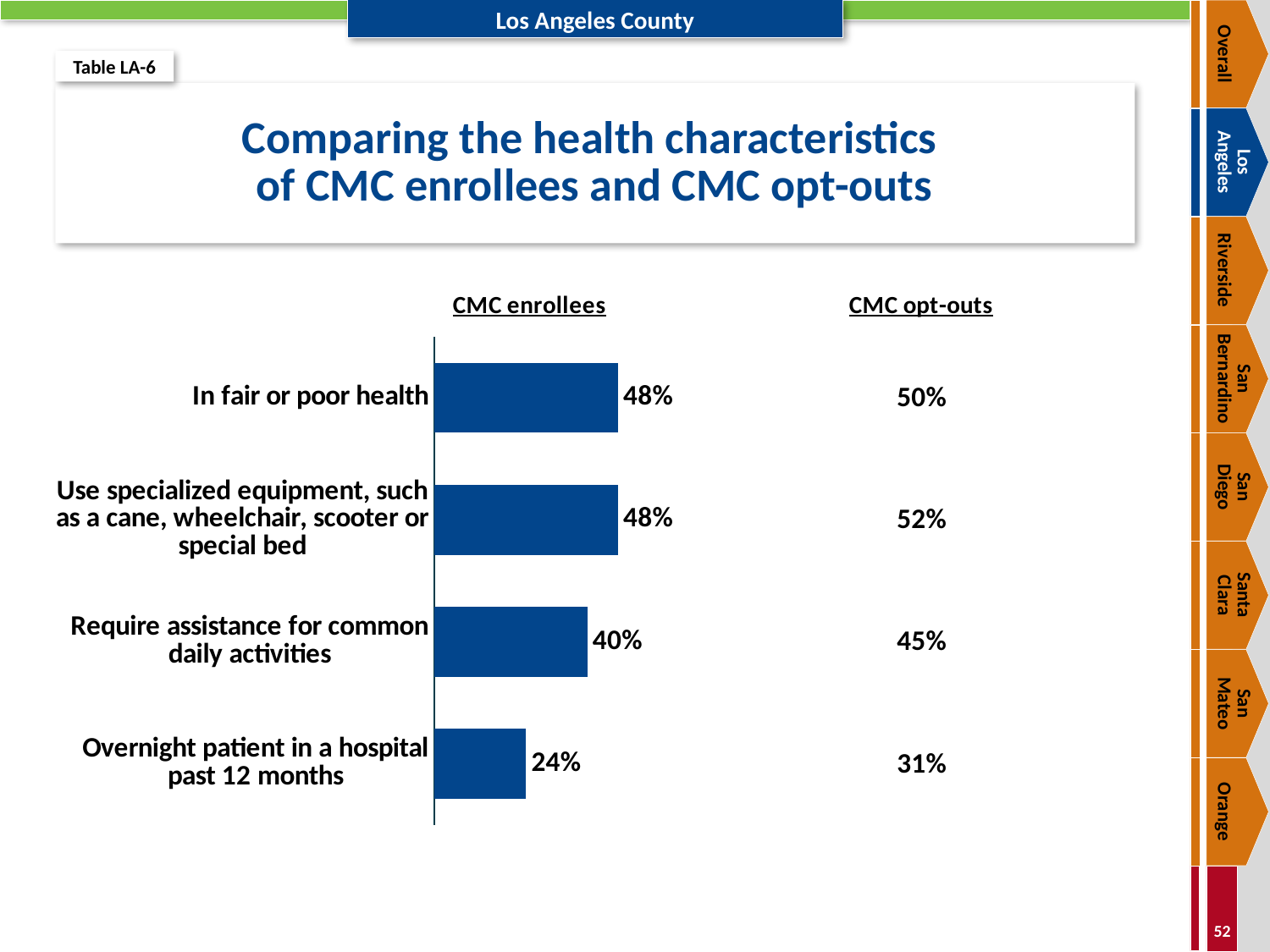
What percentage of CMC enrollees require assistance for common daily activities? 40% What type of chart is used to show the CMC enrollee percentages? Bar chart What percentage of CMC opt-outs use specialized equipment, such as a cane, wheelchair, scooter or special bed? 52% What is the difference between the CMC enrollee percentages for 'In fair or poor health' and 'Overnight patient in a hospital past 12 months'? 24 percentage points How many health characteristics are shown in the chart? 4 What is the title of the chart on this slide? Comparing the health characteristics of CMC enrollees and CMC opt-outs For CMC enrollees, which is larger: 'Require assistance for common daily activities' or 'Overnight patient in a hospital past 12 months'? Require assistance for common daily activities What percentage of CMC enrollees were an overnight patient in a hospital in the past 12 months? 24% What are the two column headings shown above the chart data? CMC enrollees and CMC opt-outs How much higher is the CMC opt-out percentage than the CMC enrollee percentage for 'Overnight patient in a hospital past 12 months'? 7 percentage points Which health characteristic has the lowest percentage among CMC enrollees? Overnight patient in a hospital past 12 months What percentage of CMC enrollees are in fair or poor health? 48%